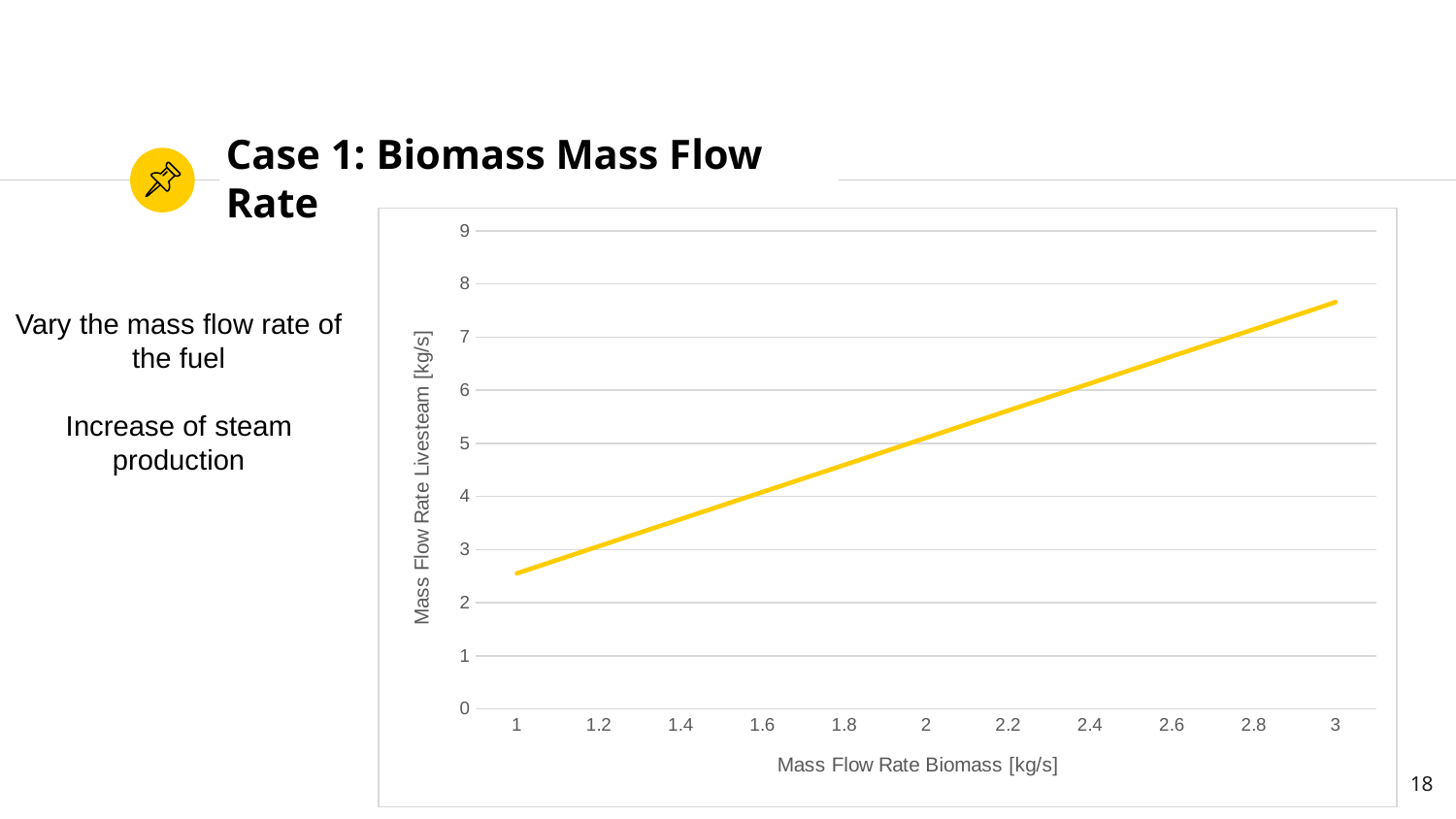
At which biomass mass flow rate shown on the x axis is the Mass Flow Rate Livesteam lowest? 1 Which has the larger Mass Flow Rate Livesteam: a biomass mass flow rate of 1 kg/s or 3 kg/s? 3 kg/s Is the Mass Flow Rate Livesteam at a biomass mass flow rate of 2.2 kg/s greater or less than 5? greater Does the Mass Flow Rate Livesteam rise or fall as the Mass Flow Rate Biomass increases along the x axis? rise Is the Mass Flow Rate Livesteam at a biomass mass flow rate of 1.4 kg/s greater or less than 3? greater Is the Mass Flow Rate Livesteam at a biomass mass flow rate of 1 kg/s greater or less than 3? less What is the label of the y axis of the chart? Mass Flow Rate Livesteam [kg/s] At which biomass mass flow rate shown on the x axis is the Mass Flow Rate Livesteam highest? 3 What kind of chart is shown on the slide? line chart